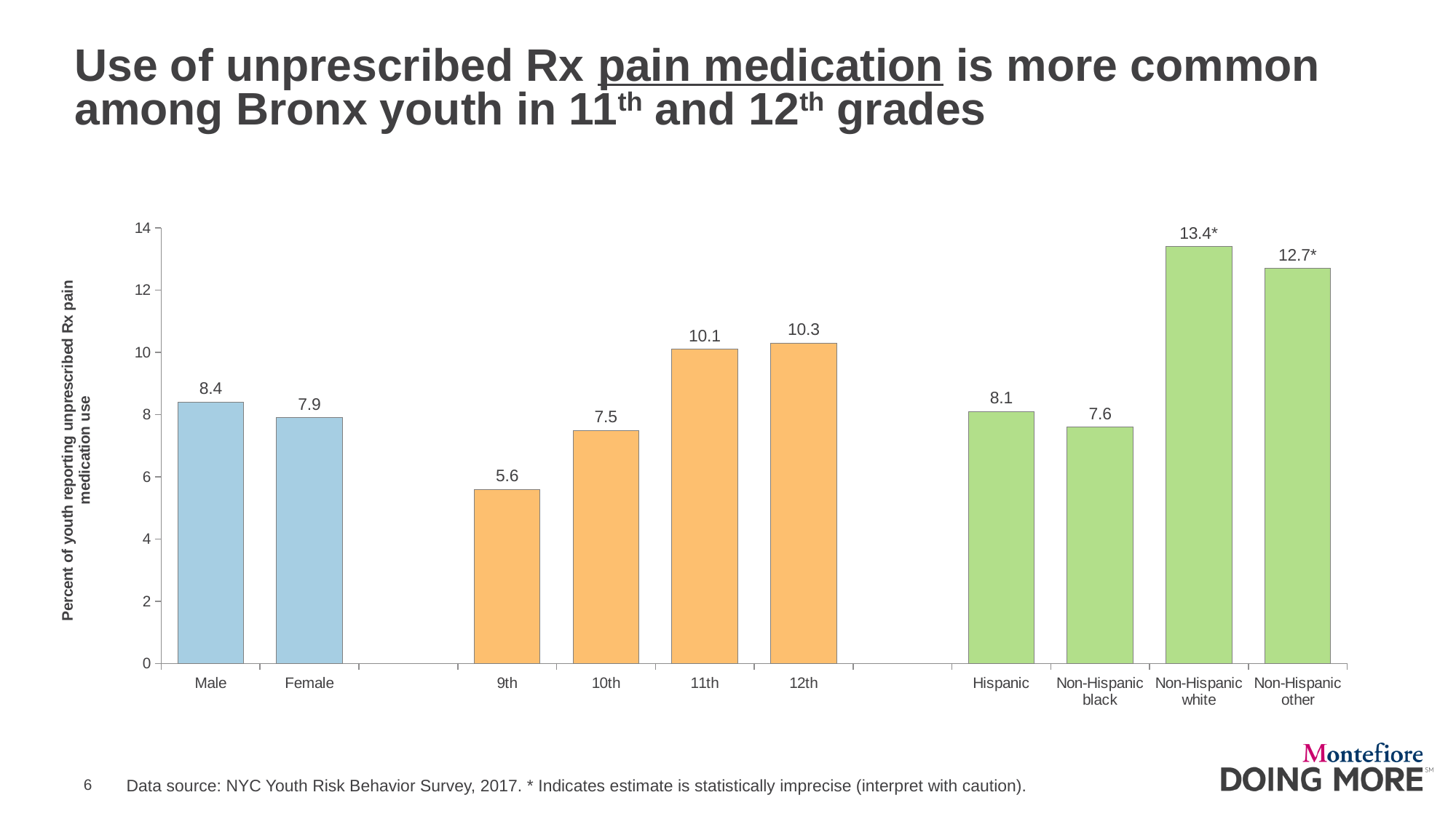
Which category has the lowest value? 9th What is the value for Non-Hispanic white? 13.4* Do the values rise or fall from 9th grade to 12th grade? rise How many bars are shown in the chart? 10 What is the value for Male? 8.4 What is the difference between the values for 12th grade and 9th grade? 4.7 What kind of chart is this? bar chart Is the value for Non-Hispanic other greater or less than 12? greater What is the value for 9th grade? 5.6 What is the y-axis label of the chart? Percent of youth reporting unprescribed Rx pain medication use Which is larger, the value for Male or the value for Female? Male Which category has the highest value? Non-Hispanic white